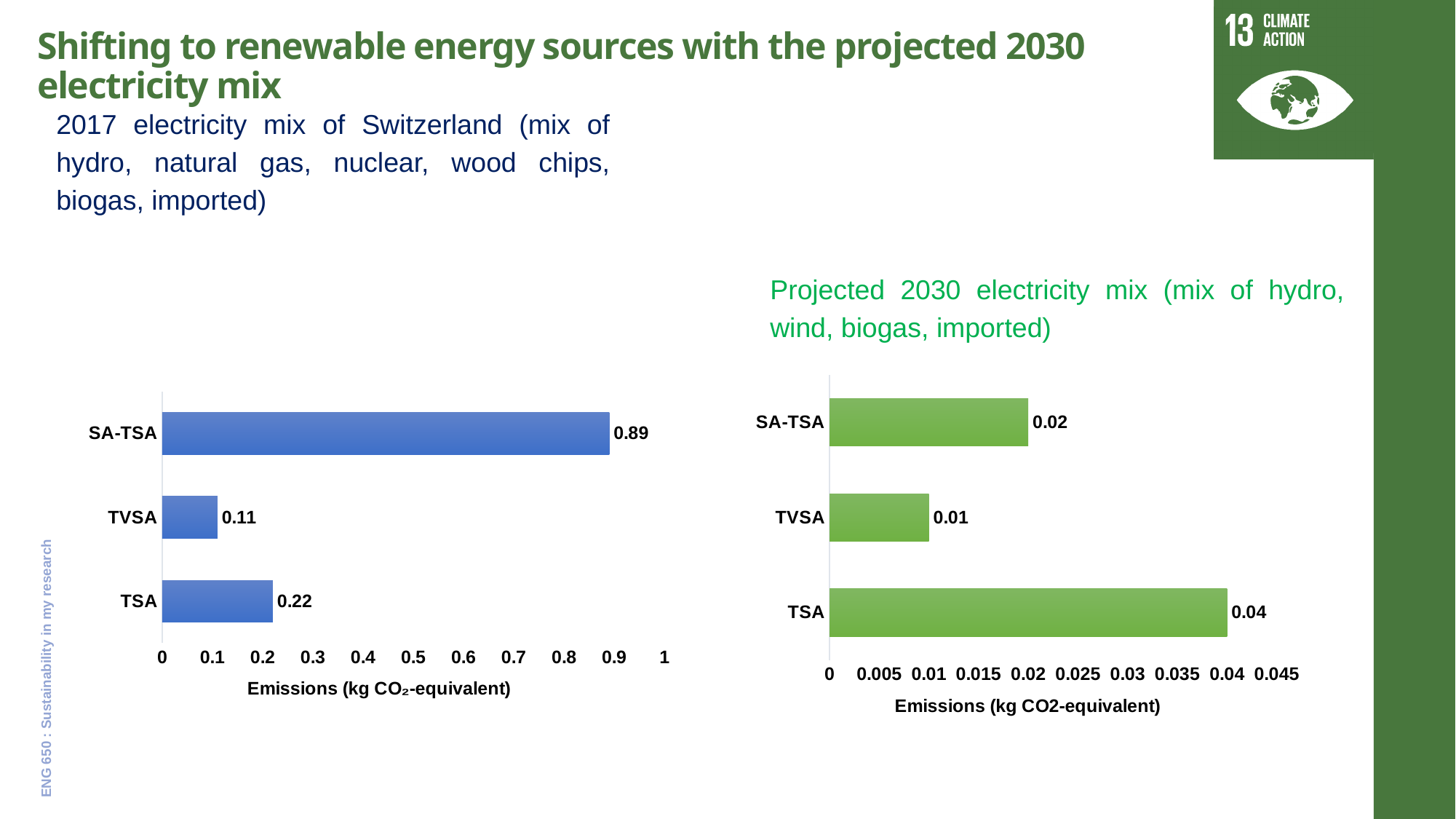
In the left chart (2017 electricity mix), what is the emissions value for TVSA? 0.11 What kind of chart is the left chart (2017 electricity mix)? Bar chart In the right chart (projected 2030 electricity mix), which category has the highest emissions? TSA In the left chart (2017 electricity mix), which category has the highest emissions? SA-TSA In the left chart (2017 electricity mix), which category has the lowest emissions? TVSA In the right chart (projected 2030 electricity mix), what is the difference between the emissions for TSA and SA-TSA? 0.02 In the right chart (projected 2030 electricity mix), what is the emissions value for TSA? 0.04 In the left chart (2017 electricity mix), what is the emissions value for SA-TSA? 0.89 In the left chart (2017 electricity mix), which is larger, the value for TSA or the value for TVSA? TSA How many categories are shown in the right chart (projected 2030 electricity mix)? 3 In the left chart (2017 electricity mix), what is the difference between the emissions for SA-TSA and TSA? 0.67 In the right chart (projected 2030 electricity mix), what is the emissions value for TVSA? 0.01